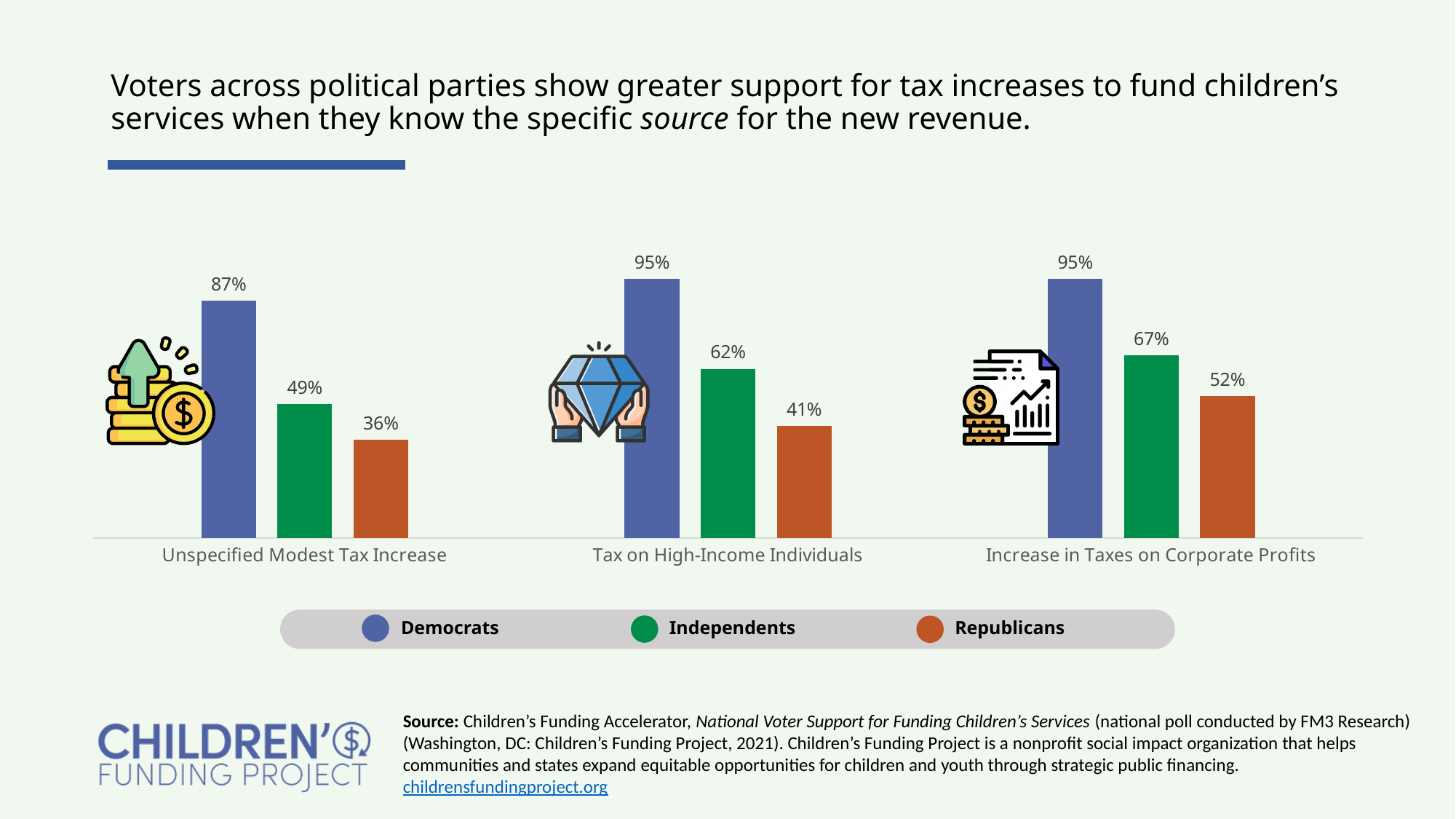
What percentage of Democrats support an Unspecified Modest Tax Increase? 87% How many categories are shown on the x axis? 3 Which category has the highest Independent support? Increase in Taxes on Corporate Profits What percentage of Independents support an Increase in Taxes on Corporate Profits? 67% Is Republican support higher for Increase in Taxes on Corporate Profits or for Tax on High-Income Individuals? Increase in Taxes on Corporate Profits Which colour represents Independents in the legend? Green How many series does the legend list? 3 What is the difference between Democrat and Republican support for a Tax on High-Income Individuals? 54% What is the difference between Independent support for Increase in Taxes on Corporate Profits and for Unspecified Modest Tax Increase? 18% What percentage of Republicans support a Tax on High-Income Individuals? 41% Which category has the lowest Republican support? Unspecified Modest Tax Increase What kind of chart is shown on the slide? Bar chart